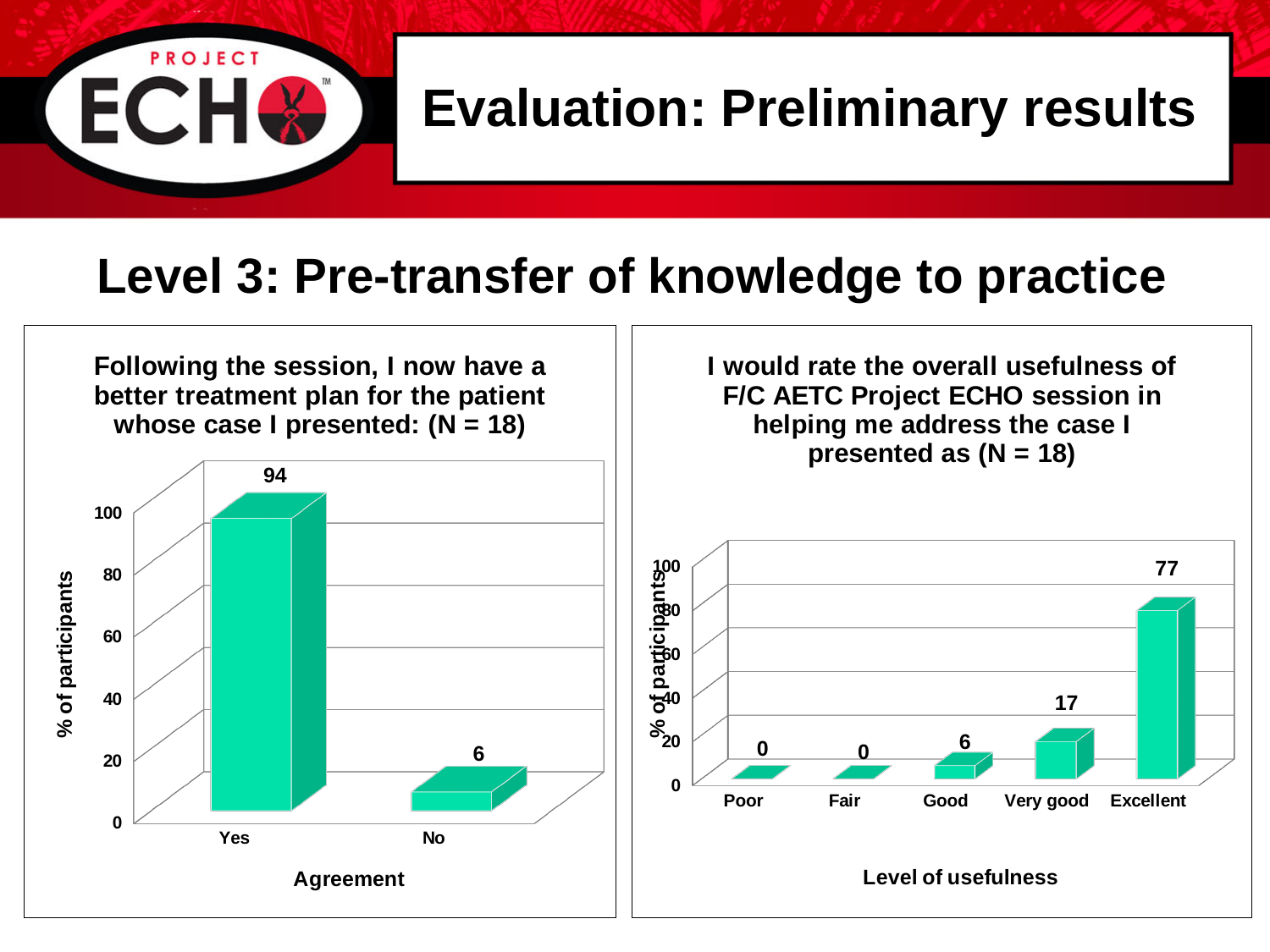
In the right chart (overall usefulness), what is the difference between the Excellent and Very good values? 60 In the right chart (overall usefulness), what is the value for Good? 6 In the left chart (better treatment plan), what is the difference between the Yes and No values? 88 In the left chart (better treatment plan), what is the x-axis title? Agreement In the left chart (better treatment plan), what is the value for Yes? 94 In the left chart (better treatment plan), what is the value for No? 6 What kind of chart is the right chart (overall usefulness)? Bar chart In the right chart (overall usefulness), what is the value for Very good? 17 In the right chart (overall usefulness), what is the value for Excellent? 77 In the right chart (overall usefulness), how many categories are shown on the x axis? 5 In the left chart (better treatment plan), how many categories are shown on the x axis? 2 In the right chart (overall usefulness), which category has the highest value? Excellent